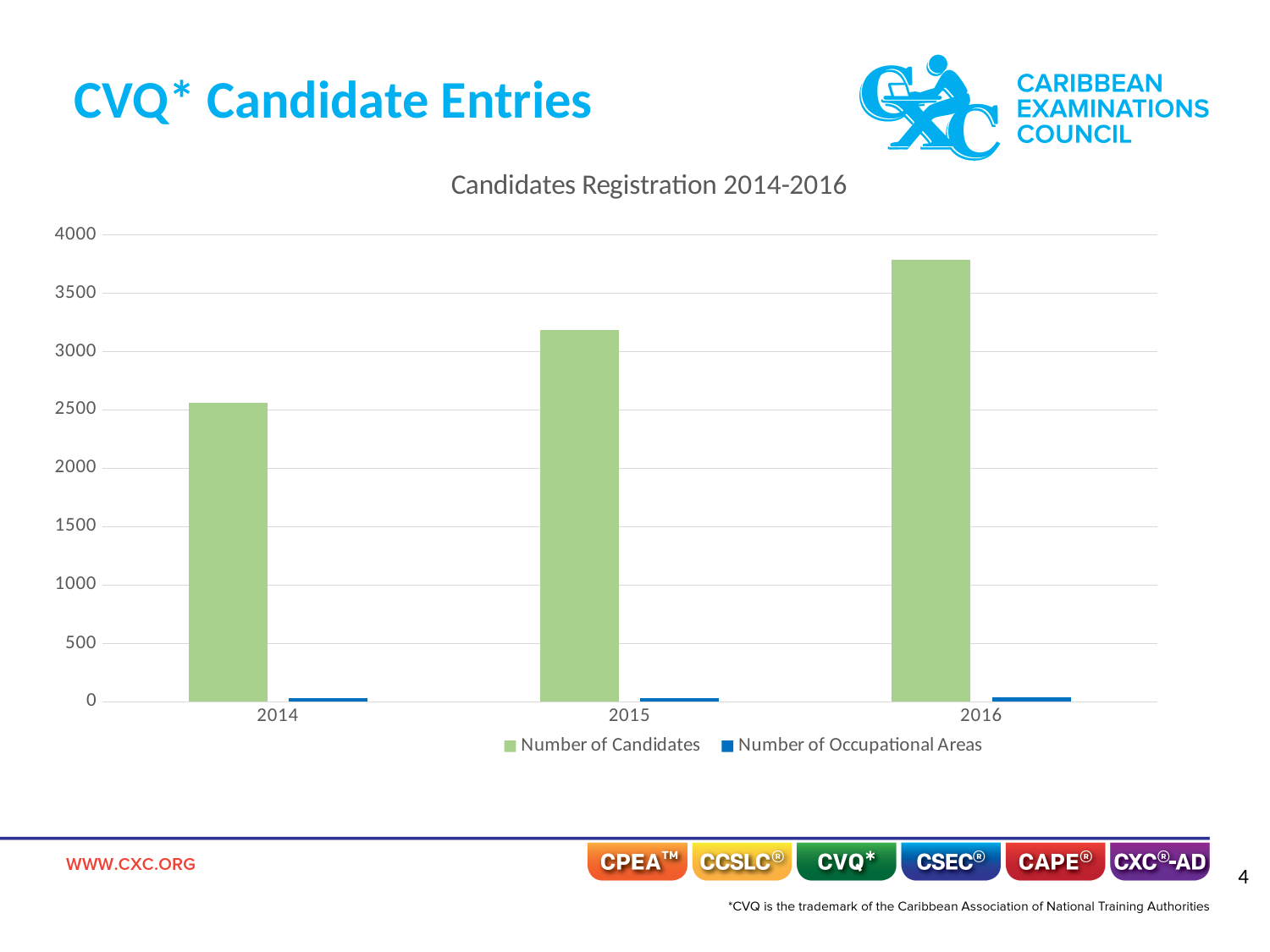
Does the Number of Candidates rise or fall from 2014 to 2016? rise Is the Number of Candidates for 2015 greater or less than 3500? less Which is larger in 2015: the Number of Candidates or the Number of Occupational Areas? Number of Candidates Which colour represents the Number of Occupational Areas series? blue How many years are shown on the x axis? 3 What is the title of the chart? Candidates Registration 2014-2016 Is the Number of Candidates for 2014 greater or less than 2500? greater How many series does the legend list? 2 Is the Number of Candidates for 2016 greater or less than 3500? greater Which year has the highest Number of Candidates? 2016 Which year has the lowest Number of Candidates? 2014 What kind of chart is shown on the slide? bar chart